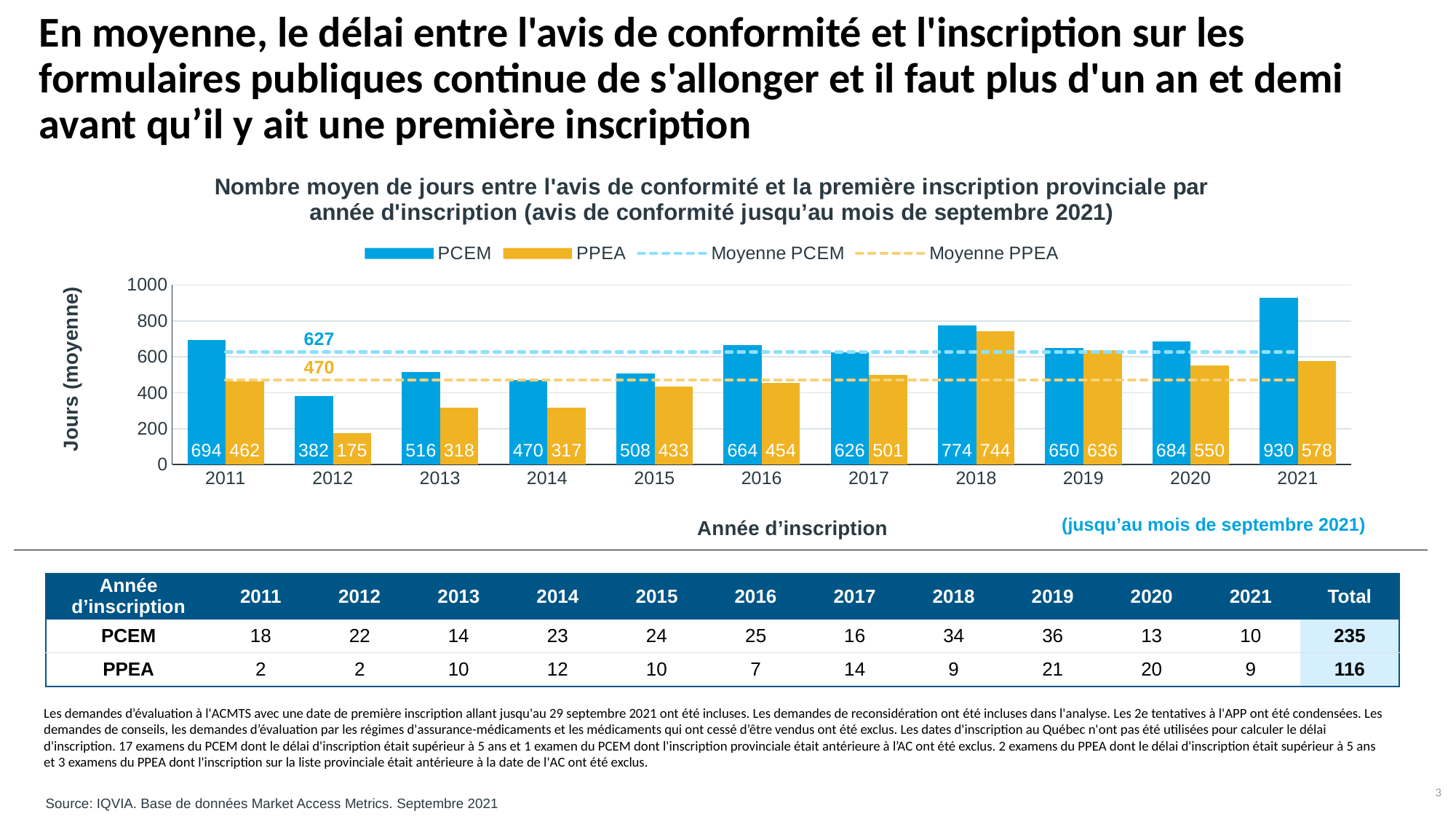
What is the PPEA value for 2012? 175 How many years are shown on the x axis of the chart? 11 How many series does the chart legend list? 4 Which year has the highest PCEM value? 2021 What is the difference between the PCEM and PPEA values in 2018? 30 What is the PCEM value for 2021? 930 What is the label of the y axis? Jours (moyenne) Which year has the lowest PPEA value? 2012 What is the value of the Moyenne PPEA line? 470 What is the value of the Moyenne PCEM line? 627 Which is larger in 2013, the PCEM value or the PPEA value? PCEM What kind of chart is shown on the slide? bar chart